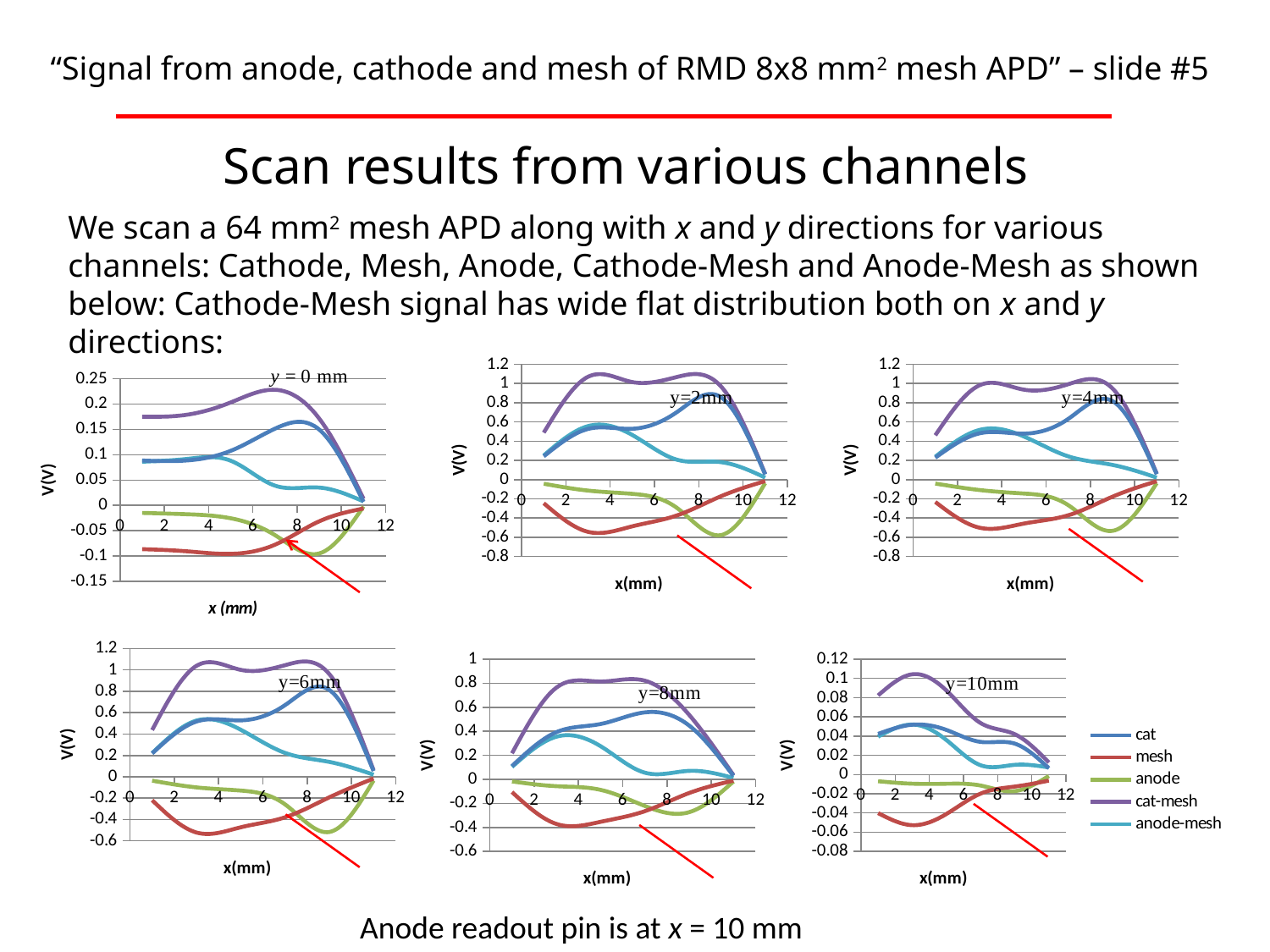
In the y=10mm chart, is the value of cat-mesh at x = 4 greater or less than 0.08? greater What kind of chart is the y = 0 mm chart? line chart In the y = 0 mm chart, is the value of cat-mesh at x = 2 greater or less than 0.1? greater In the y=8mm chart, is the value of cat at x = 8 greater or less than 0.4? greater How many series does the legend on the right list? 5 What are the series names listed in the legend? cat, mesh, anode, cat-mesh, anode-mesh In the y=4mm chart, at x = 4, which is larger: cat-mesh or cat? cat-mesh What is the x-axis label of the y=2mm chart? x(mm) In the y=10mm chart, does the cat-mesh series rise or fall from x = 4 to x = 11? fall How many charts are shown on the slide? 6